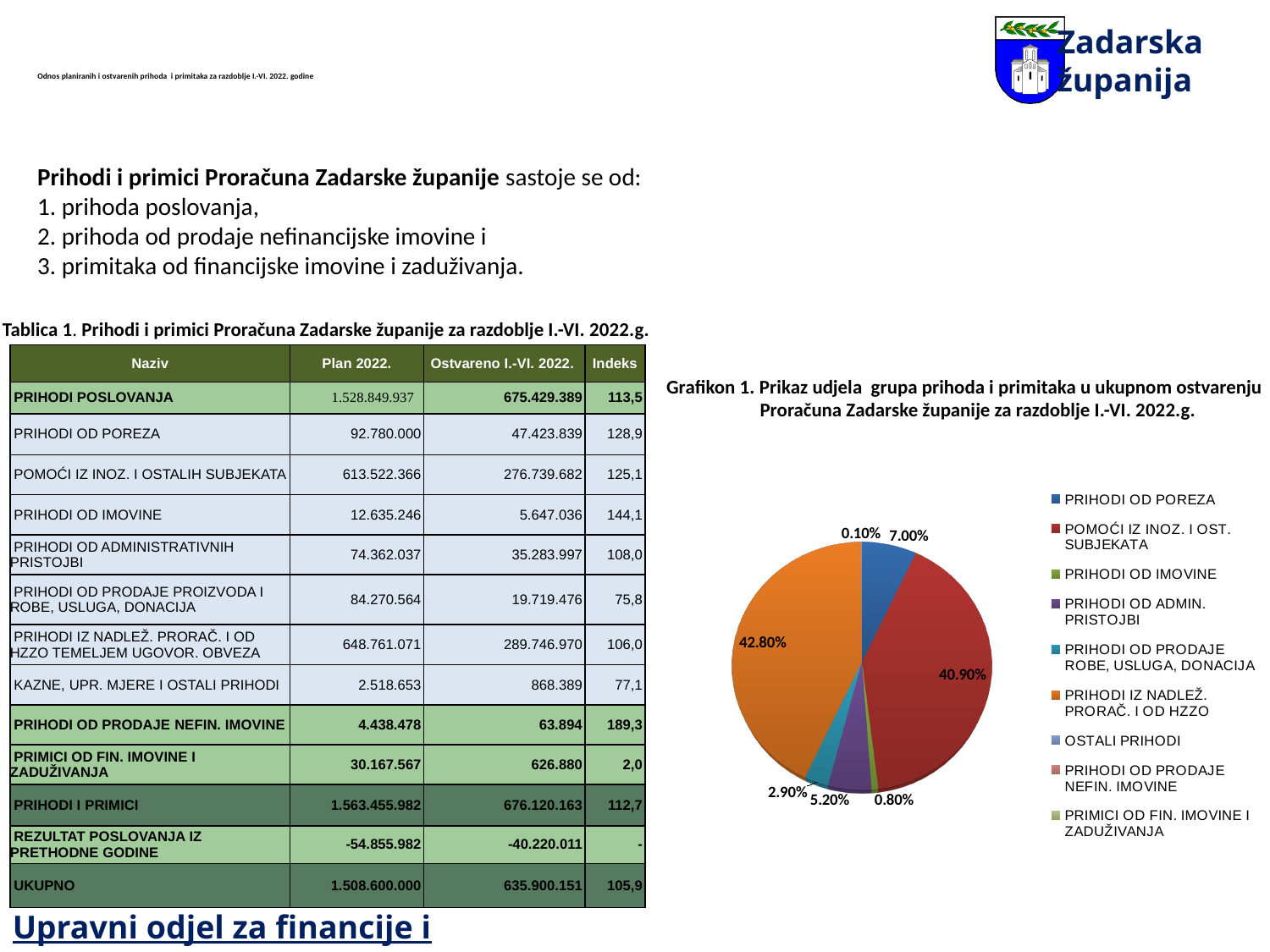
In Grafikon 1, which is larger: the share of PRIHODI OD POREZA or the share of PRIHODI OD ADMIN. PRISTOJBI? PRIHODI OD POREZA In Grafikon 1, what is the difference in percentage points between the share of PRIHODI IZ NADLEŽ. PRORAČ. I OD HZZO and the share of POMOĆI IZ INOZ. I OST. SUBJEKATA? 1.90% In Grafikon 1, what share does PRIHODI OD PRODAJE ROBE, USLUGA, DONACIJA have? 2.90% What kind of chart is Grafikon 1 on the slide? pie chart How many entries does the legend of Grafikon 1 list? 9 In Grafikon 1, what share does PRIHODI IZ NADLEŽ. PRORAČ. I OD HZZO have? 42.80% In Grafikon 1, what share does PRIHODI OD POREZA have? 7.00% In Grafikon 1, which category has the largest share of the pie? PRIHODI IZ NADLEŽ. PRORAČ. I OD HZZO In Grafikon 1, what share does PRIHODI OD ADMIN. PRISTOJBI have? 5.20% In Grafikon 1, what share does POMOĆI IZ INOZ. I OST. SUBJEKATA have? 40.90% In Grafikon 1, what colour is the slice for PRIHODI IZ NADLEŽ. PRORAČ. I OD HZZO? orange In Grafikon 1, what share does PRIHODI OD IMOVINE have? 0.80%